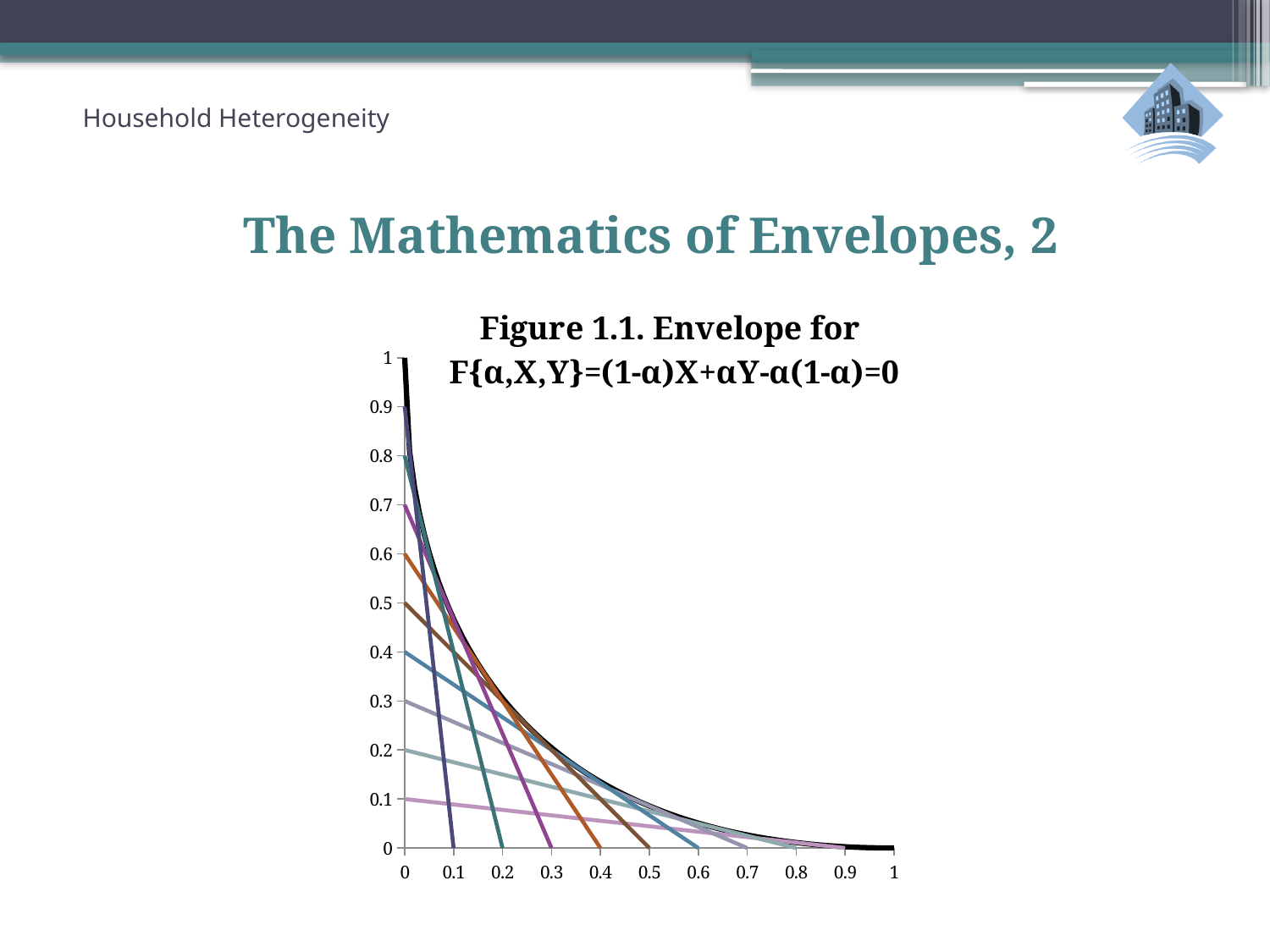
What is the value of the envelope curve at x = 0? 1 At what x value does the straight line that meets the y axis at 0.5 cross the x axis? 0.5 Is the value of the envelope curve at x = 0.1 greater or less than 0.6? less Does the black envelope curve rise or fall as x increases from 0 to 1? fall What kind of chart is shown on the slide? line chart At what x value does the straight line that meets the y axis at 0.1 cross the x axis? 0.9 What is the highest value labelled on the y axis? 1 What is the title of the chart? Figure 1.1. Envelope for F{α,X,Y}=(1-α)X+αY-α(1-α)=0 How many straight lines are drawn tangent to the envelope curve? 9 At what x value does the straight line that meets the y axis at 0.9 cross the x axis? 0.1 Is the value of the envelope curve at x = 0.4 greater or less than 0.2? less